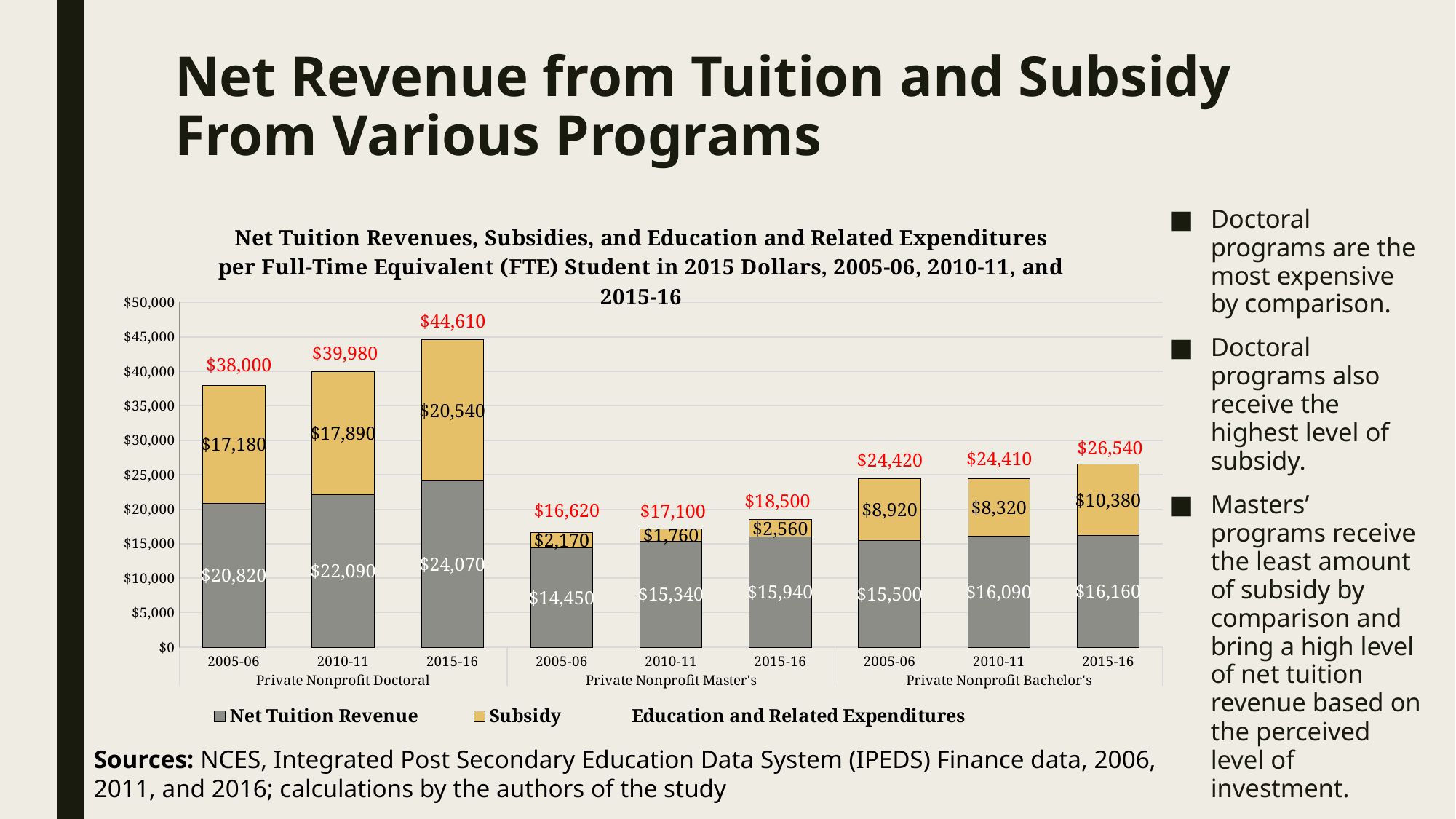
How many series does the chart legend list? 3 What is the Subsidy for Private Nonprofit Master's in 2010-11? $1,760 What is the difference between the Subsidy for Private Nonprofit Doctoral in 2015-16 and in 2010-11? $2,650 Does the Net Tuition Revenue for Private Nonprofit Doctoral rise or fall from 2005-06 to 2015-16? Rise What is the Education and Related Expenditures value for Private Nonprofit Bachelor's in 2015-16? $26,540 Which is larger: the Net Tuition Revenue for Private Nonprofit Bachelor's in 2005-06 or for Private Nonprofit Master's in 2005-06? Private Nonprofit Bachelor's 2005-06 Which bar has the lowest Subsidy value? Private Nonprofit Master's 2010-11 How many bars are plotted in the chart? 9 What is the total of the stacked bar for Private Nonprofit Master's in 2015-16? $18,500 Which bar has the highest Education and Related Expenditures value? Private Nonprofit Doctoral 2015-16 What kind of chart is shown on the slide? Stacked bar chart What is the Net Tuition Revenue for Private Nonprofit Doctoral in 2015-16? $24,070